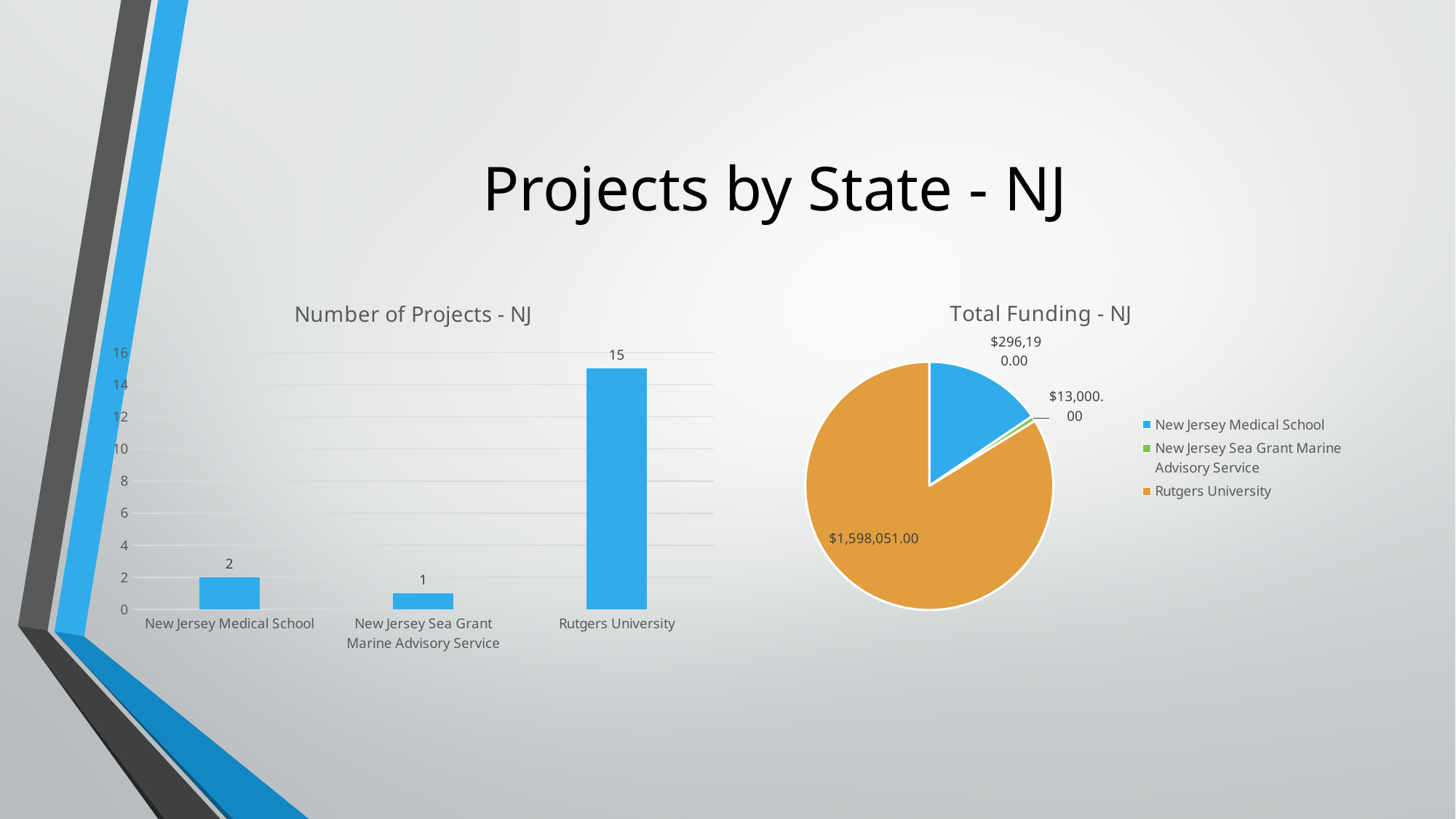
In the "Total Funding - NJ" chart, what is the difference between the funding for Rutgers University and New Jersey Medical School? $1,301,861.00 In the "Number of Projects - NJ" chart, how many projects does Rutgers University have? 15 What kind of chart is "Number of Projects - NJ"? Bar chart In the "Total Funding - NJ" chart, which is larger, the funding for New Jersey Medical School or for New Jersey Sea Grant Marine Advisory Service? New Jersey Medical School How many entries does the legend of the "Total Funding - NJ" chart list? 3 In the "Number of Projects - NJ" chart, which category has the lowest number of projects? New Jersey Sea Grant Marine Advisory Service In the "Number of Projects - NJ" chart, how many projects does New Jersey Medical School have? 2 In the "Total Funding - NJ" chart, what is the total funding for New Jersey Sea Grant Marine Advisory Service? $13,000.00 In the "Number of Projects - NJ" chart, how many categories are shown on the x axis? 3 In the "Number of Projects - NJ" chart, what is the difference between the number of projects for Rutgers University and New Jersey Medical School? 13 In the "Number of Projects - NJ" chart, which category has the highest number of projects? Rutgers University In the "Total Funding - NJ" chart, what is the total funding for Rutgers University? $1,598,051.00